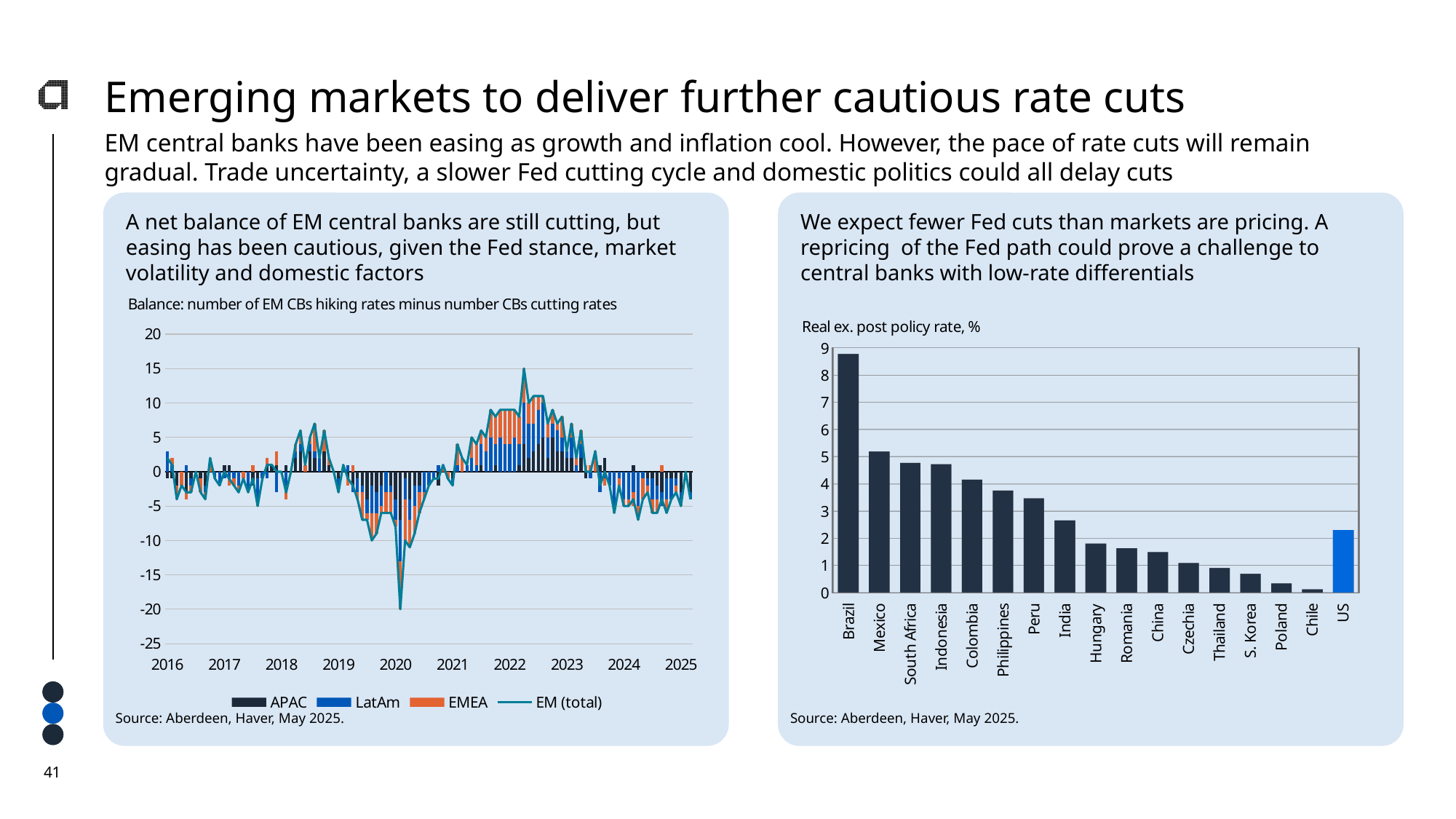
In the chart titled 'Real ex. post policy rate, %', is the value for Mexico greater or less than 5? greater In the chart titled 'Real ex. post policy rate, %', which country has the lowest value? Chile What kind of chart is the chart titled 'Real ex. post policy rate, %'? Bar chart How many countries are shown in the chart titled 'Real ex. post policy rate, %'? 17 In the chart titled 'Real ex. post policy rate, %', is the value for Brazil greater or less than 8? greater How many entries does the legend list in the left-hand chart on EM central bank balance? 4 In the left-hand chart on EM central bank balance, which series is shown as a line rather than bars? EM (total) In the chart titled 'Real ex. post policy rate, %', which country has the highest value? Brazil In the chart titled 'Real ex. post policy rate, %', which has the larger value, US or Hungary? US In the chart titled 'Real ex. post policy rate, %', which has the larger value, Colombia or Peru? Colombia In the left-hand chart on EM central bank balance, is the lowest value of the EM (total) line, reached in 2020, greater or less than -15? less